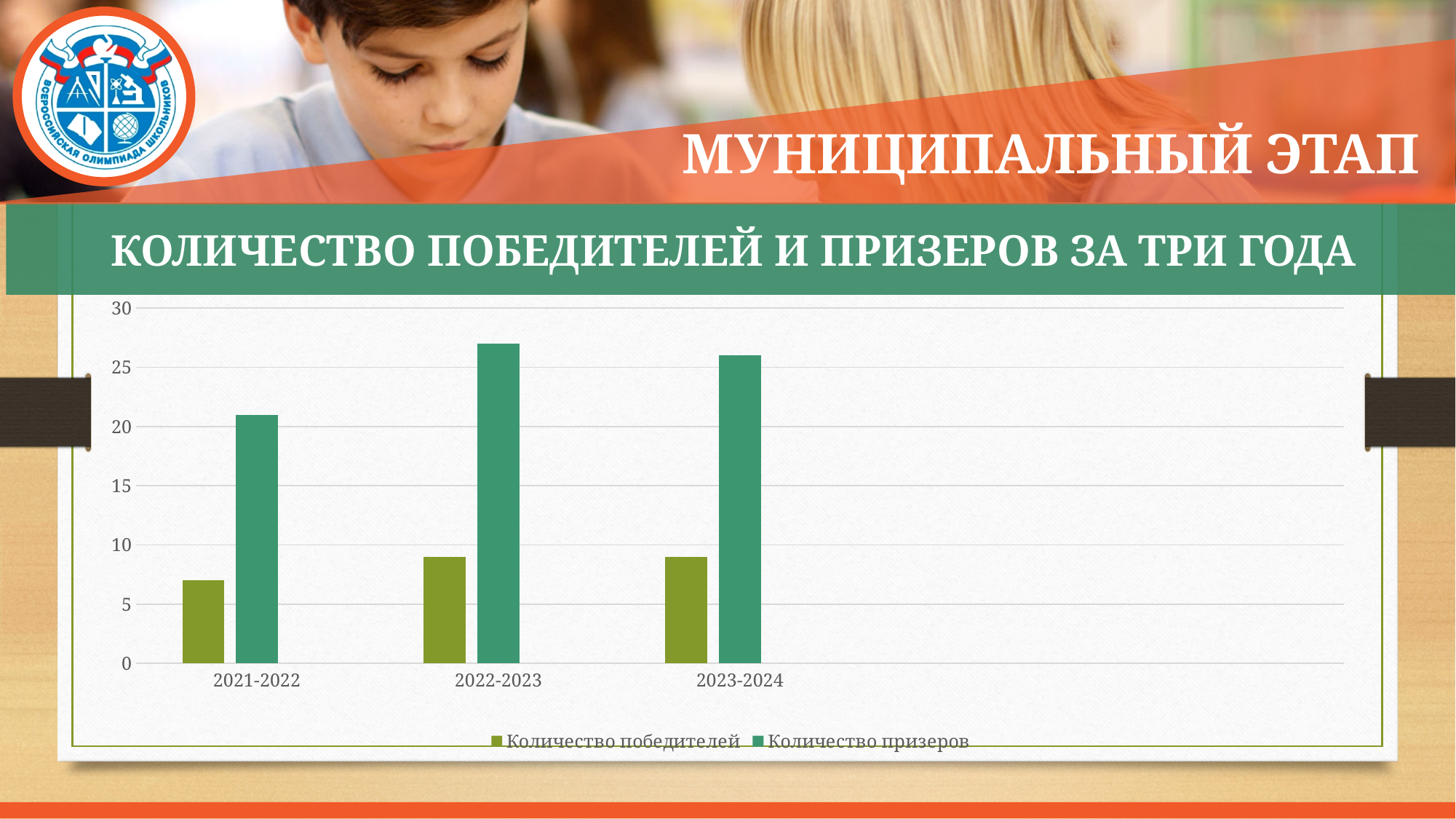
Which series is shown in the darker green colour? Количество призеров Does the value for Количество победителей rise or fall from 2021-2022 to 2022-2023? rise How many series does the legend list? 2 In 2022-2023, which is larger: Количество победителей or Количество призеров? Количество призеров Which year has the lowest value for Количество призеров? 2021-2022 Is the value for Количество призеров in 2022-2023 greater or less than 25? greater How many year categories are shown on the x axis? 3 What kind of chart is shown on the slide? bar chart Is the value for Количество победителей in 2021-2022 greater or less than 10? less Which year has the lowest value for Количество победителей? 2021-2022 What is the title of the chart? КОЛИЧЕСТВО ПОБЕДИТЕЛЕЙ И ПРИЗЕРОВ ЗА ТРИ ГОДА Is the value for Количество призеров in 2021-2022 greater or less than 25? less